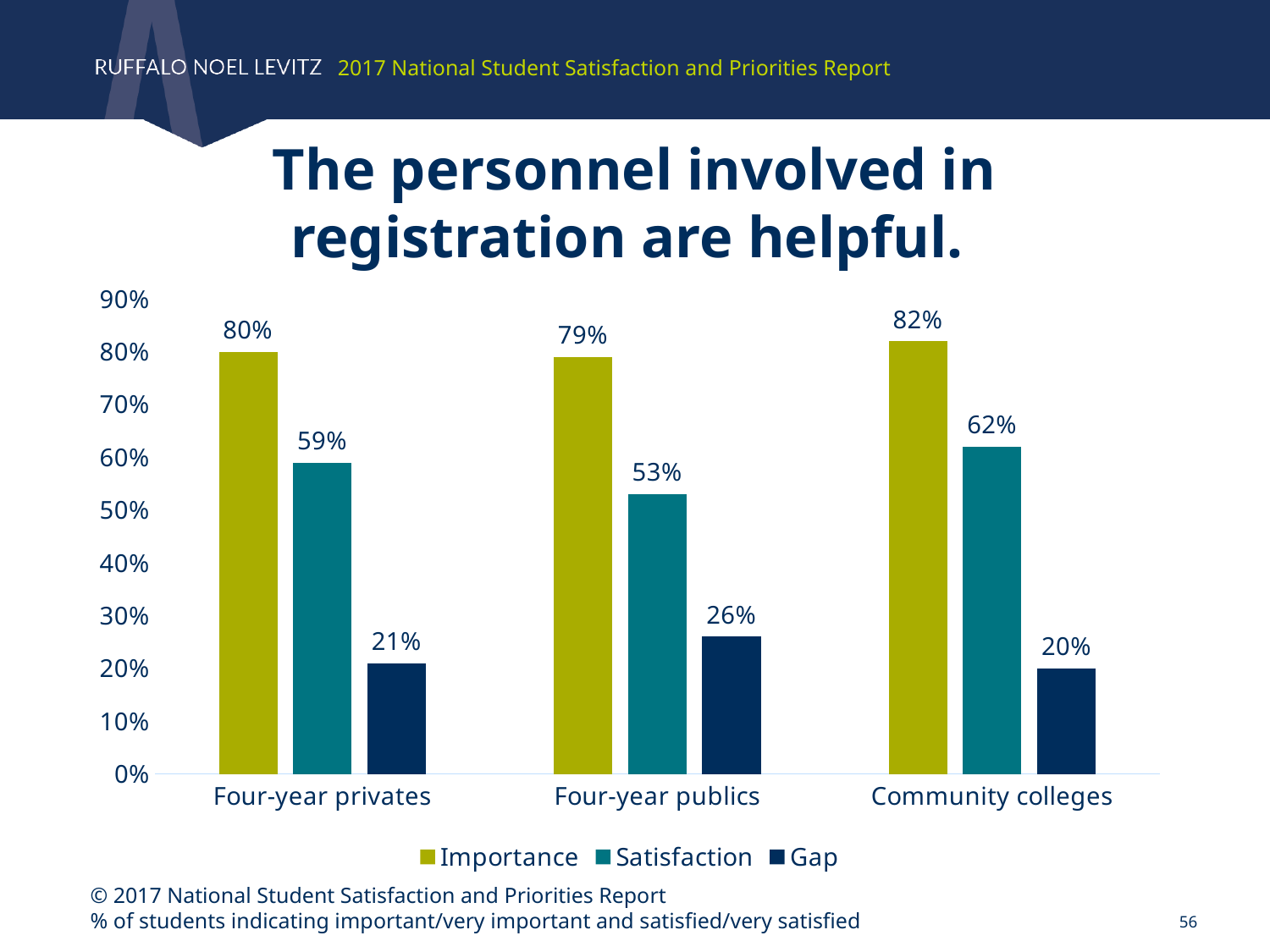
What kind of chart is shown on the slide? Bar chart Which is larger, the Gap for Four-year publics or the Gap for Community colleges? Four-year publics Which category has the highest Importance value? Community colleges How many series does the legend list? 3 What is the title of the chart? The personnel involved in registration are helpful. How many categories are shown on the x axis? 3 Which category has the lowest Satisfaction value? Four-year publics What is the Gap value for Community colleges? 20% What is the Satisfaction value for Four-year publics? 53% Is the Satisfaction value for Community colleges greater or less than 60%? greater What is the difference between Importance and Satisfaction for Four-year privates? 21% What is the Importance value for Four-year privates? 80%